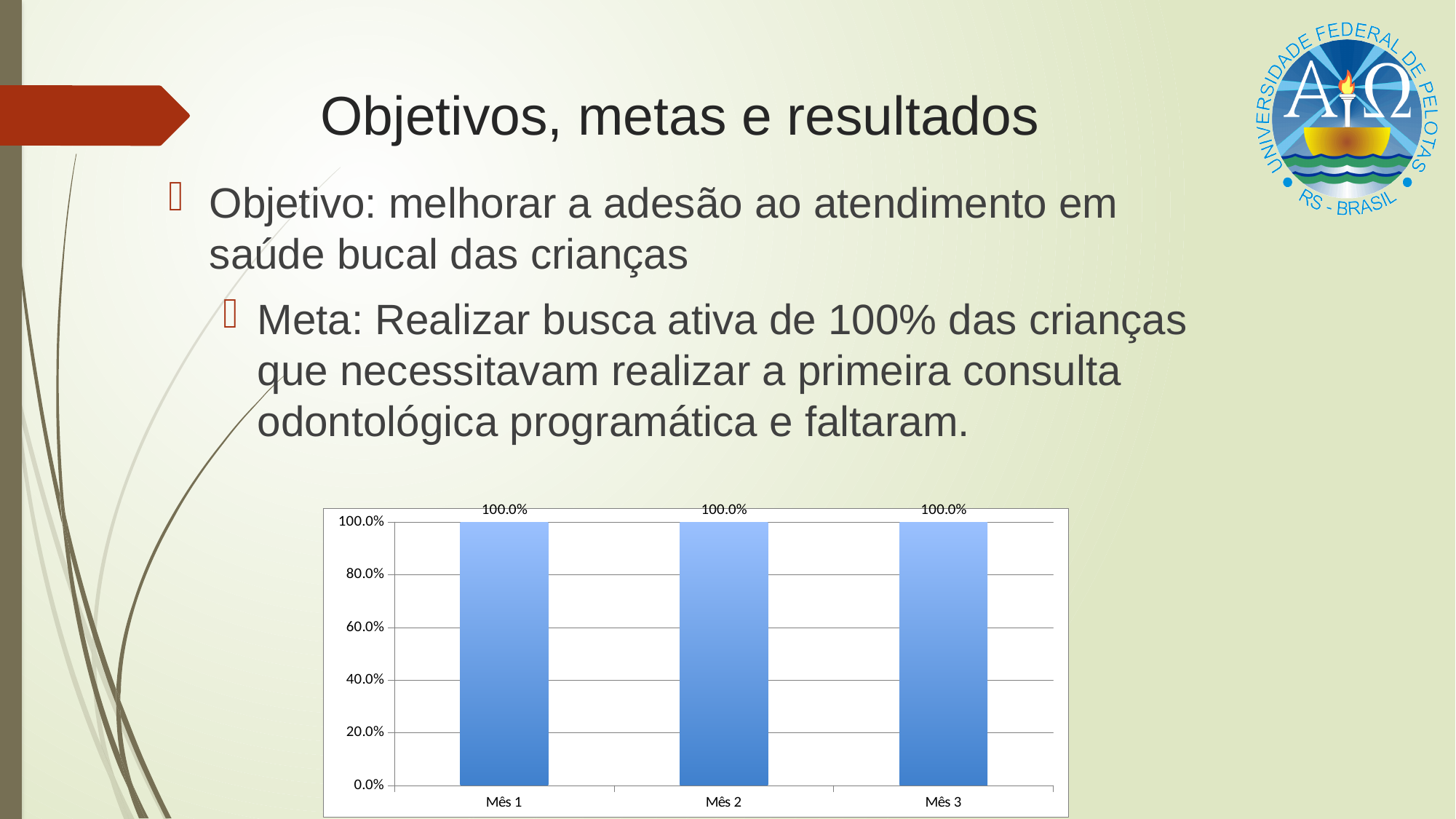
What is the highest value shown on the y axis of the chart? 100.0% What is the value for Mês 1? 100.0% What is the value for Mês 3? 100.0% Do the values rise, fall or stay the same from Mês 1 to Mês 3? stay the same What kind of chart is shown on the slide? bar chart What colour are the bars in the chart? blue Is the value for Mês 2 greater or less than 80.0%? greater How many categories are shown on the x axis of the chart? 3 What is the value for Mês 2? 100.0% What is the difference between the values for Mês 1 and Mês 3? 0.0%